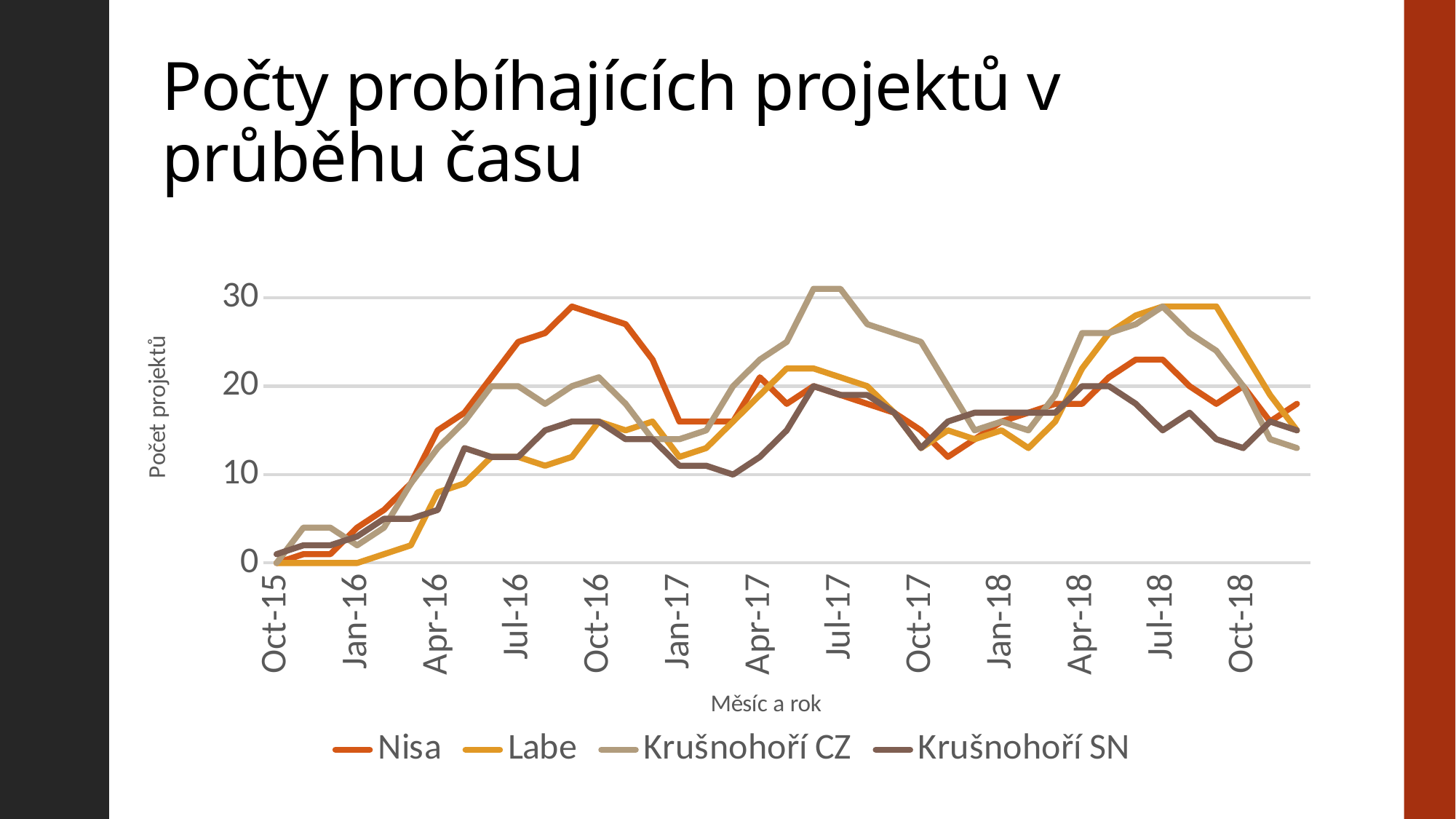
Is the value for Nisa at Oct-16 greater or less than 20? greater How many series does the legend list? 4 Is the value for Krušnohoří CZ at Jul-17 greater or less than 20? greater What is the title of the chart on the slide? Počty probíhajících projektů v průběhu času At Oct-16, which series has the larger value, Nisa or Labe? Nisa Is the value for Labe at Jan-16 greater or less than 10? less At Jul-17, which series has the larger value, Krušnohoří CZ or Krušnohoří SN? Krušnohoří CZ What is the label of the vertical axis? Počet projektů Which series has the highest value at Jul-17? Krušnohoří CZ What kind of chart is shown on the slide? line chart Which series has the lowest value at Apr-17? Krušnohoří SN